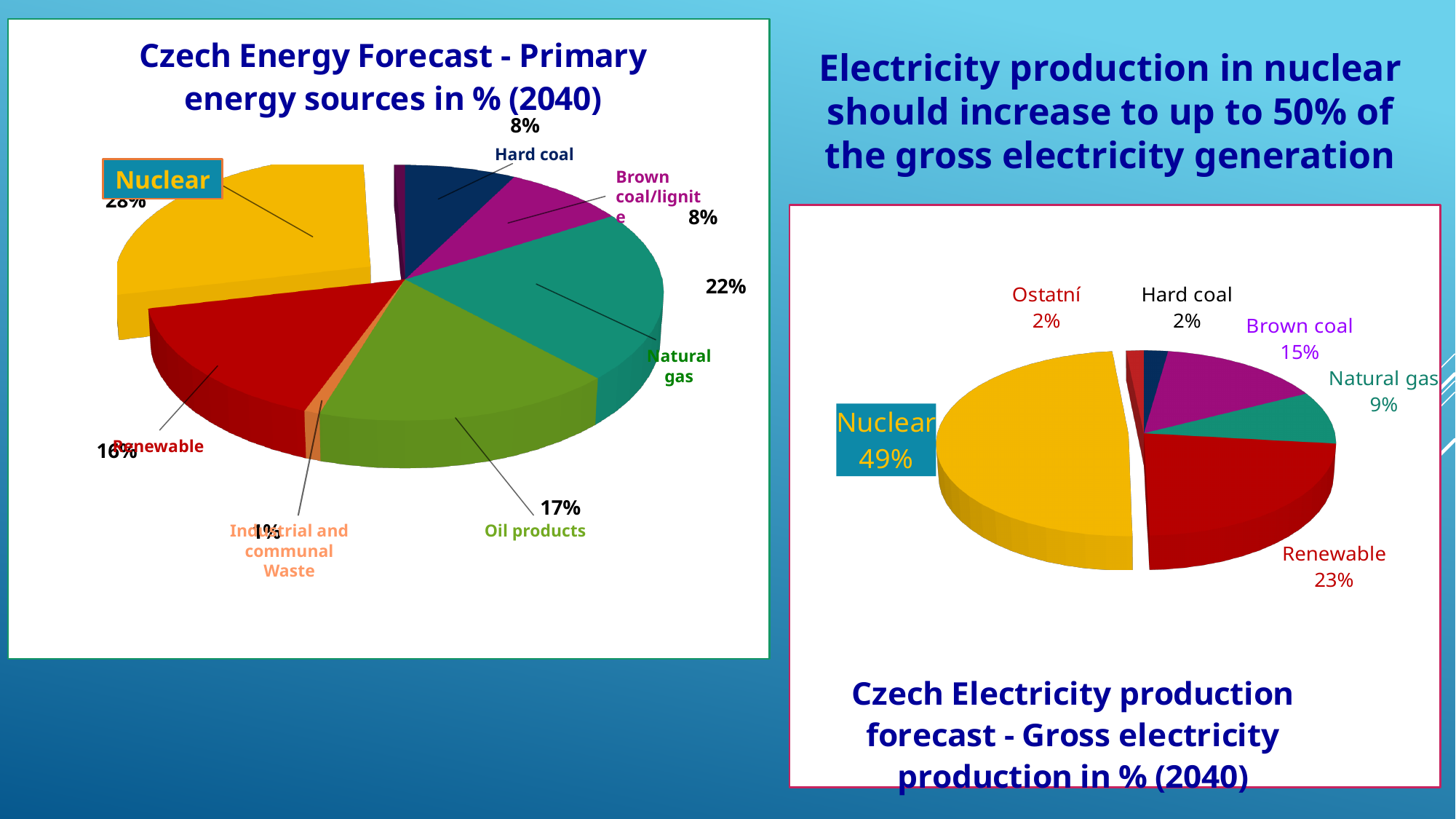
What type of chart is the Czech Electricity production forecast chart? Pie chart In the Czech Electricity production forecast chart, what is the share for Nuclear? 49% In the Czech Energy Forecast - Primary energy sources chart, what is the difference between the shares of Natural gas and Renewable? 6% In the Czech Electricity production forecast chart, what is the difference between the shares of Renewable and Natural gas? 14% In the Czech Electricity production forecast chart, which category has the largest share? Nuclear In the Czech Energy Forecast - Primary energy sources chart, what is the share for Industrial and communal Waste? 1% In the Czech Energy Forecast - Primary energy sources chart, which category has the smallest share? Industrial and communal Waste In the Czech Energy Forecast - Primary energy sources chart, which is larger, Oil products or Hard coal? Oil products In the Czech Energy Forecast - Primary energy sources chart, what is the share for Oil products? 17% How many categories are shown in the Czech Electricity production forecast chart? 6 In the Czech Energy Forecast - Primary energy sources chart, what is the share for Natural gas? 22% In the Czech Electricity production forecast chart, what is the share for Brown coal? 15%